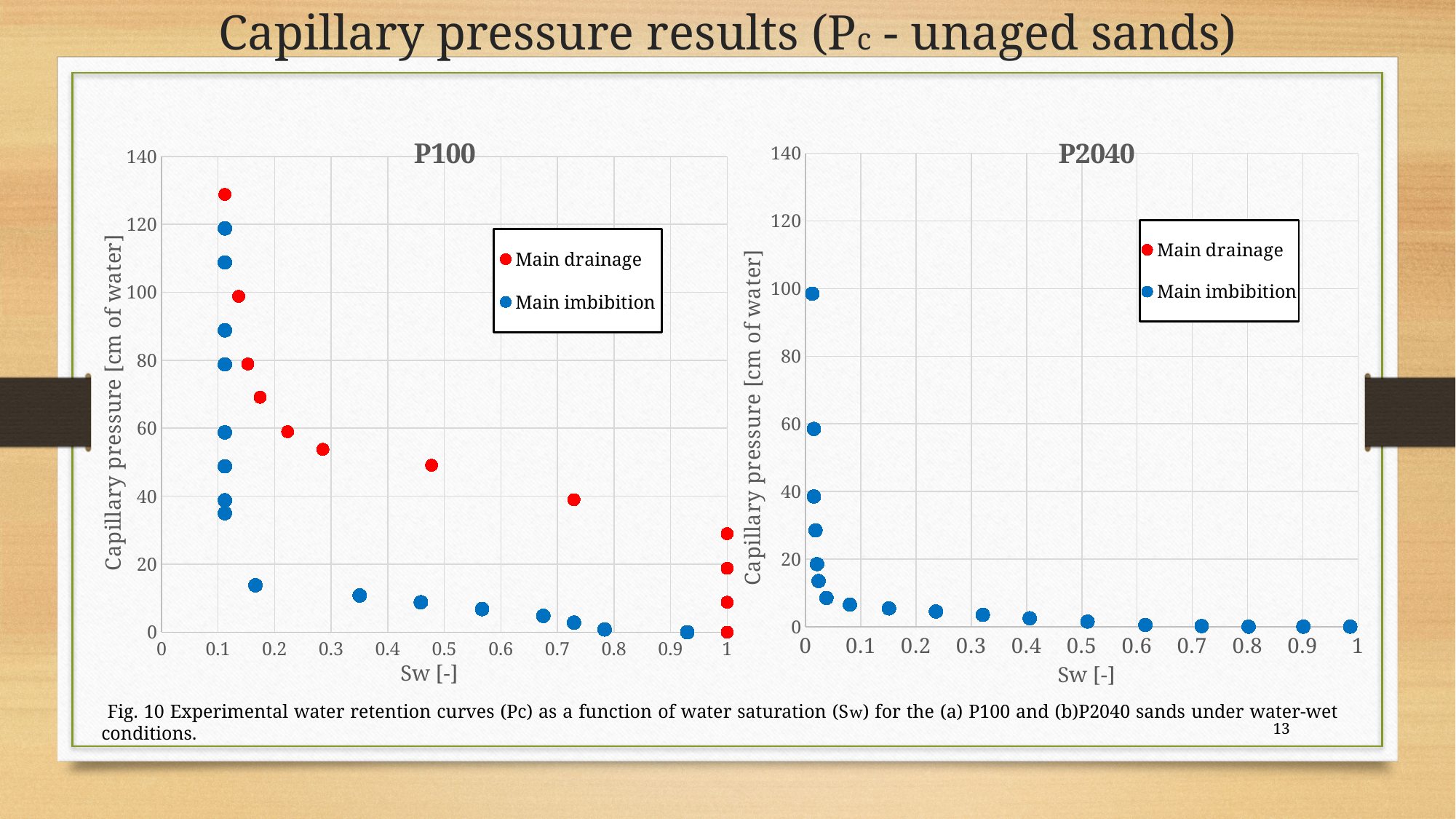
What are the two series named in the legend of the P100 chart? Main drainage and Main imbibition In the P2040 chart, is the highest Main imbibition value greater or less than 80? greater In the P2040 chart, is the Main imbibition value at Sw of about 0.9 greater or less than 20? less In the P100 chart, which series reaches the higher capillary pressure, Main drainage or Main imbibition? Main drainage What is the y-axis title of the P100 chart? Capillary pressure [cm of water] In the P100 chart, is the Main drainage value at Sw of about 0.73 greater or less than 20? greater In the P2040 chart, do the Main imbibition values rise or fall as Sw increases? fall What kind of chart is the P100 chart? Scatter chart In the P100 chart, do the Main imbibition values rise or fall as Sw increases? fall How many series does the legend of the P2040 chart list? 2